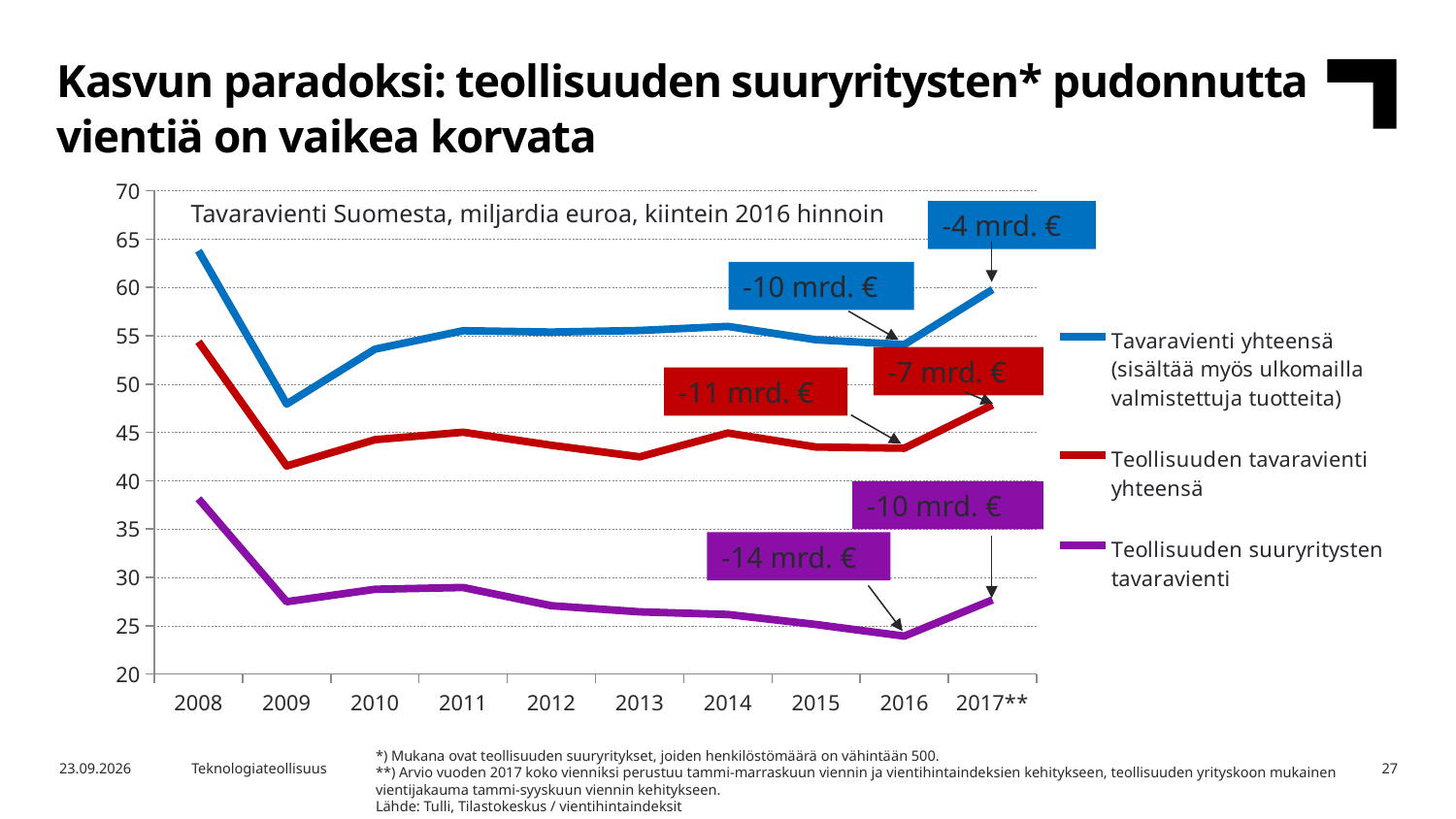
Does Tavaravienti yhteensä rise or fall from 2008 to 2009? fall Is the value for Tavaravienti yhteensä in 2008 greater or less than 60? greater How many years are shown on the x axis? 10 Is the value for Teollisuuden tavaravienti yhteensä in 2009 greater or less than 45? less What colour is the line for Teollisuuden tavaravienti yhteensä? red In which year is Tavaravienti yhteensä at its highest? 2008 Is the value for Tavaravienti yhteensä in 2017** greater or less than 55? greater What kind of chart is shown on the slide? line chart In which year is Teollisuuden suuryritysten tavaravienti at its lowest? 2016 In 2012, which is larger: Tavaravienti yhteensä or Teollisuuden suuryritysten tavaravienti? Tavaravienti yhteensä How many series does the legend list? 3